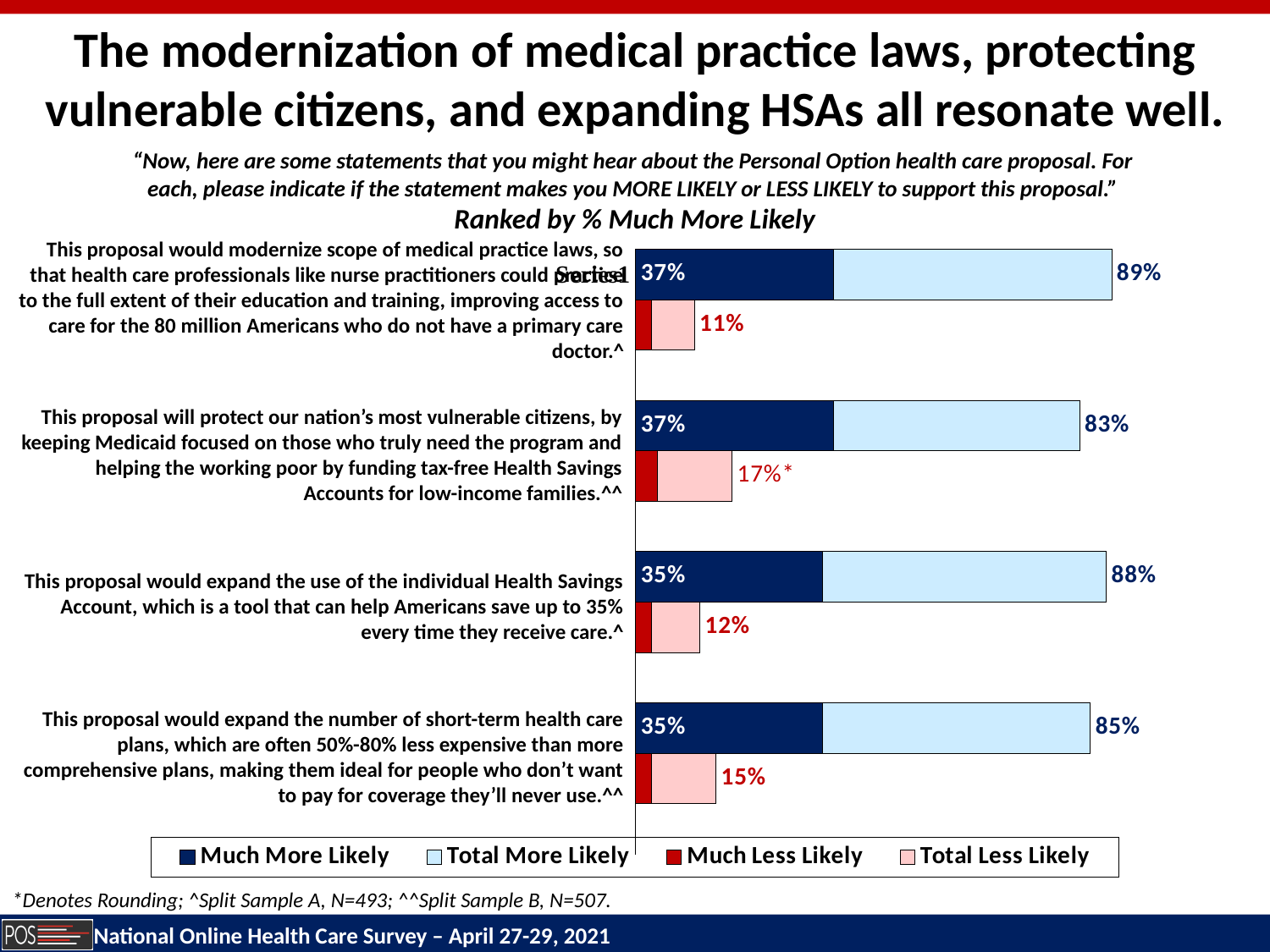
Which legend entry is shown in dark blue? Much More Likely Which statement has the lowest Total Less Likely value? This proposal would modernize scope of medical practice laws (11%) What kind of chart is shown on the slide? bar chart How many series does the legend list? 4 Which statement has the highest Total More Likely value? This proposal would modernize scope of medical practice laws (89%) What is the Much More Likely value for the statement about protecting the nation's most vulnerable citizens by keeping Medicaid focused? 37% What is the difference between the Total More Likely values for the modernizing medical practice laws statement (89%) and the protecting vulnerable citizens statement (83%)? 6 percentage points Which is larger: the Total Less Likely value for the protecting vulnerable citizens statement or for the short-term health care plans statement? Protecting vulnerable citizens (17%) What is the Total Less Likely value for the statement about expanding the use of the individual Health Savings Account? 12% How many statements (categories) are plotted in the chart? 4 What is the Total More Likely value for the statement about expanding the number of short-term health care plans? 85% What is the Total More Likely value for the statement about modernizing scope of medical practice laws? 89%